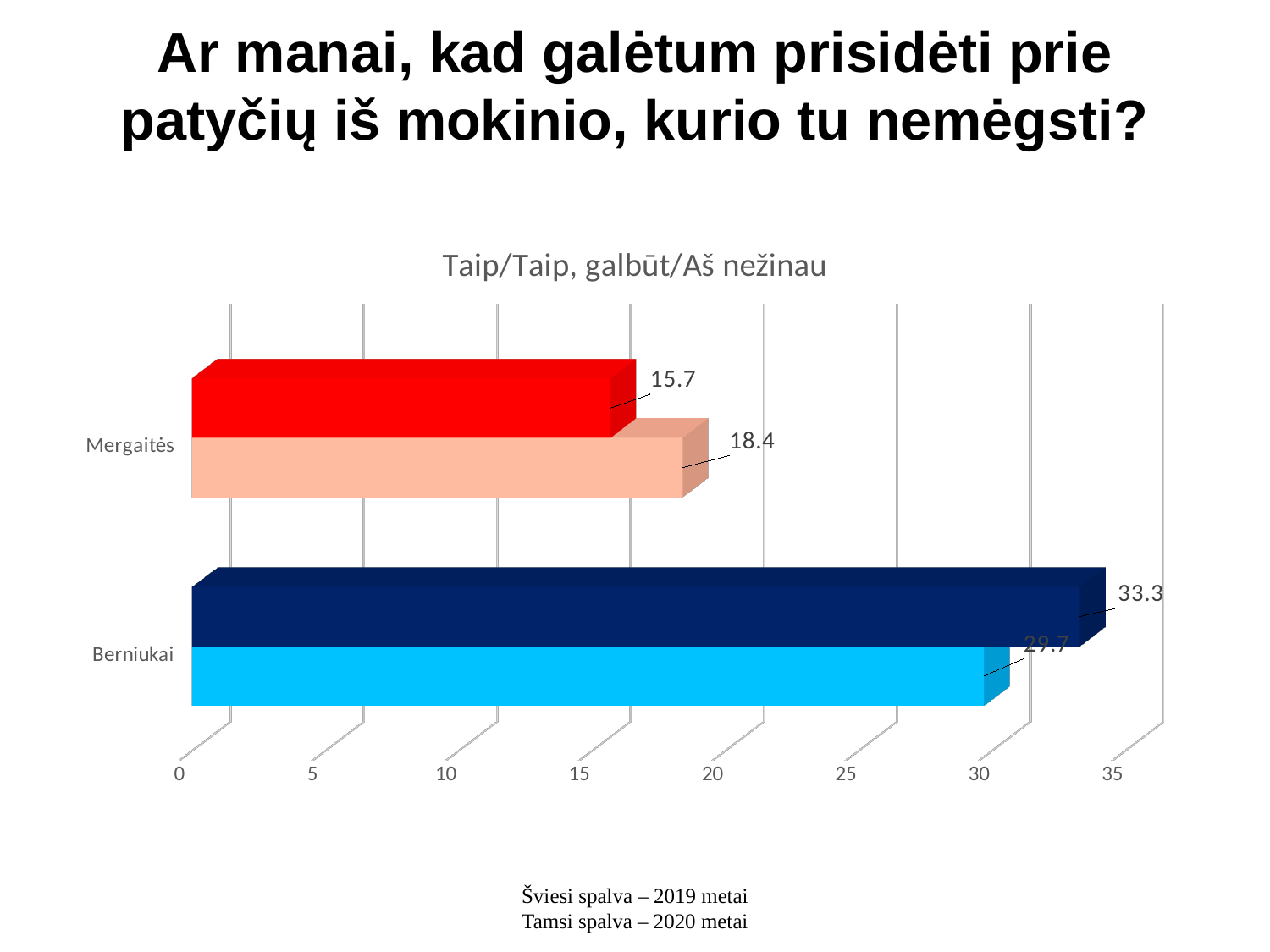
What is the 2020 (dark colour) value for Mergaitės? 15.7 Which bar has the highest value on the chart? Berniukai, 2020 (dark colour) What is the 2019 (light colour) value for Mergaitės? 18.4 What is the difference between the 2020 and 2019 values for Berniukai? 3.6 What is the difference between the 2019 and 2020 values for Mergaitės? 2.7 What is the 2019 (light colour) value for Berniukai? 29.7 What type of chart is shown on the slide? Bar chart What is the 2020 (dark colour) value for Berniukai? 33.3 How many categories are shown on the chart? 2 Which bar has the lowest value on the chart? Mergaitės, 2020 (dark colour) Is the 2019 value for Berniukai greater or less than 25? greater Which is larger for Mergaitės: the 2019 value or the 2020 value? 2019 (18.4)